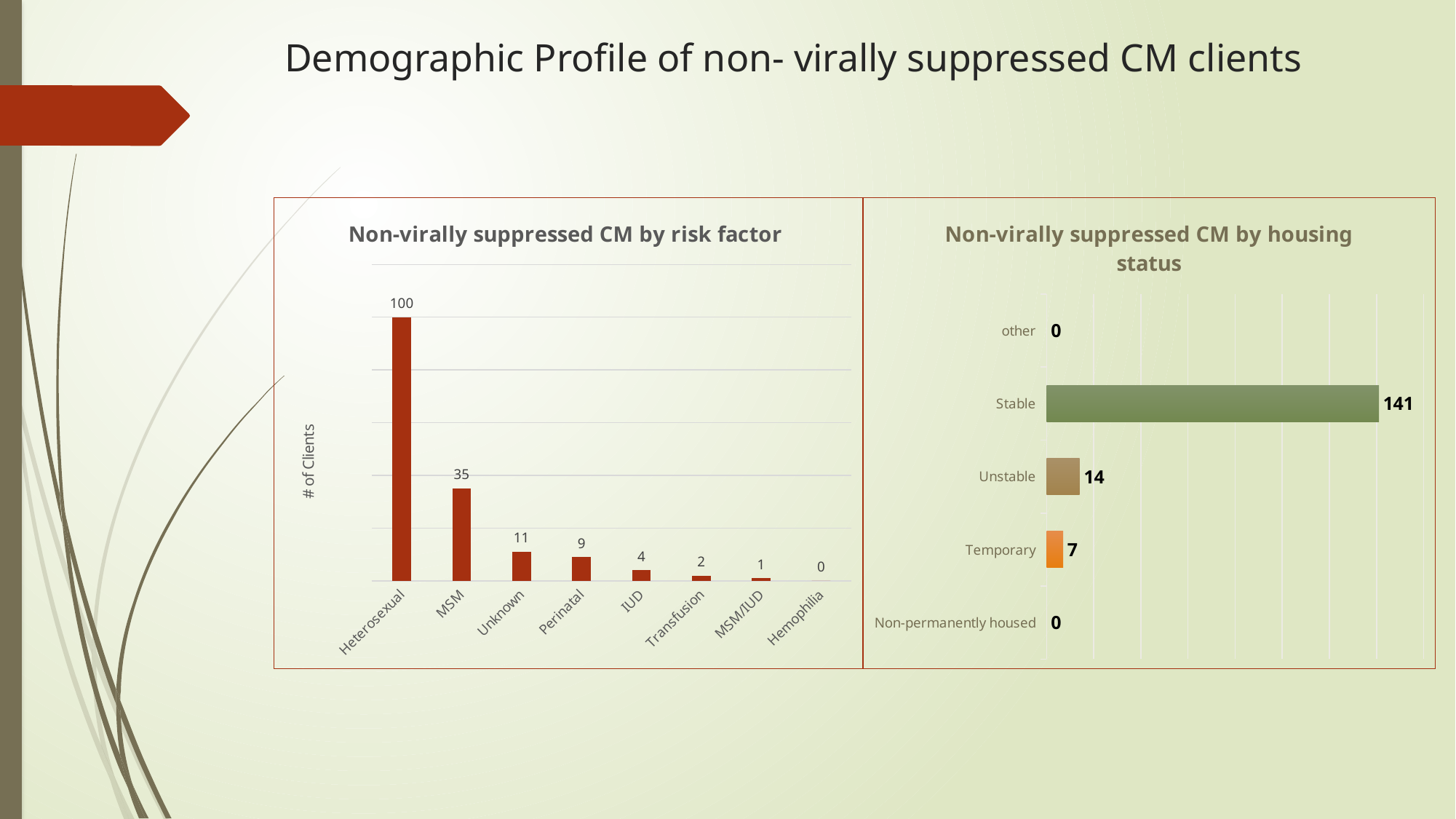
What is the y-axis label of the 'Non-virally suppressed CM by risk factor' chart? # of Clients In the 'Non-virally suppressed CM by housing status' chart, which housing status has the highest value? Stable What kind of chart is the 'Non-virally suppressed CM by housing status' chart? Bar chart In the 'Non-virally suppressed CM by housing status' chart, what is the value for Stable? 141 In the 'Non-virally suppressed CM by risk factor' chart, which is larger, Unknown or Perinatal? Unknown In the 'Non-virally suppressed CM by risk factor' chart, which risk factor has the lowest value? Hemophilia In the 'Non-virally suppressed CM by risk factor' chart, how many risk factor categories are shown? 8 In the 'Non-virally suppressed CM by risk factor' chart, what is the value for Heterosexual? 100 In the 'Non-virally suppressed CM by risk factor' chart, what is the value for MSM? 35 In the 'Non-virally suppressed CM by housing status' chart, what is the value for Unstable? 14 In the 'Non-virally suppressed CM by risk factor' chart, what is the difference between the values for Heterosexual and MSM? 65 In the 'Non-virally suppressed CM by housing status' chart, what is the difference between the values for Unstable and Temporary? 7